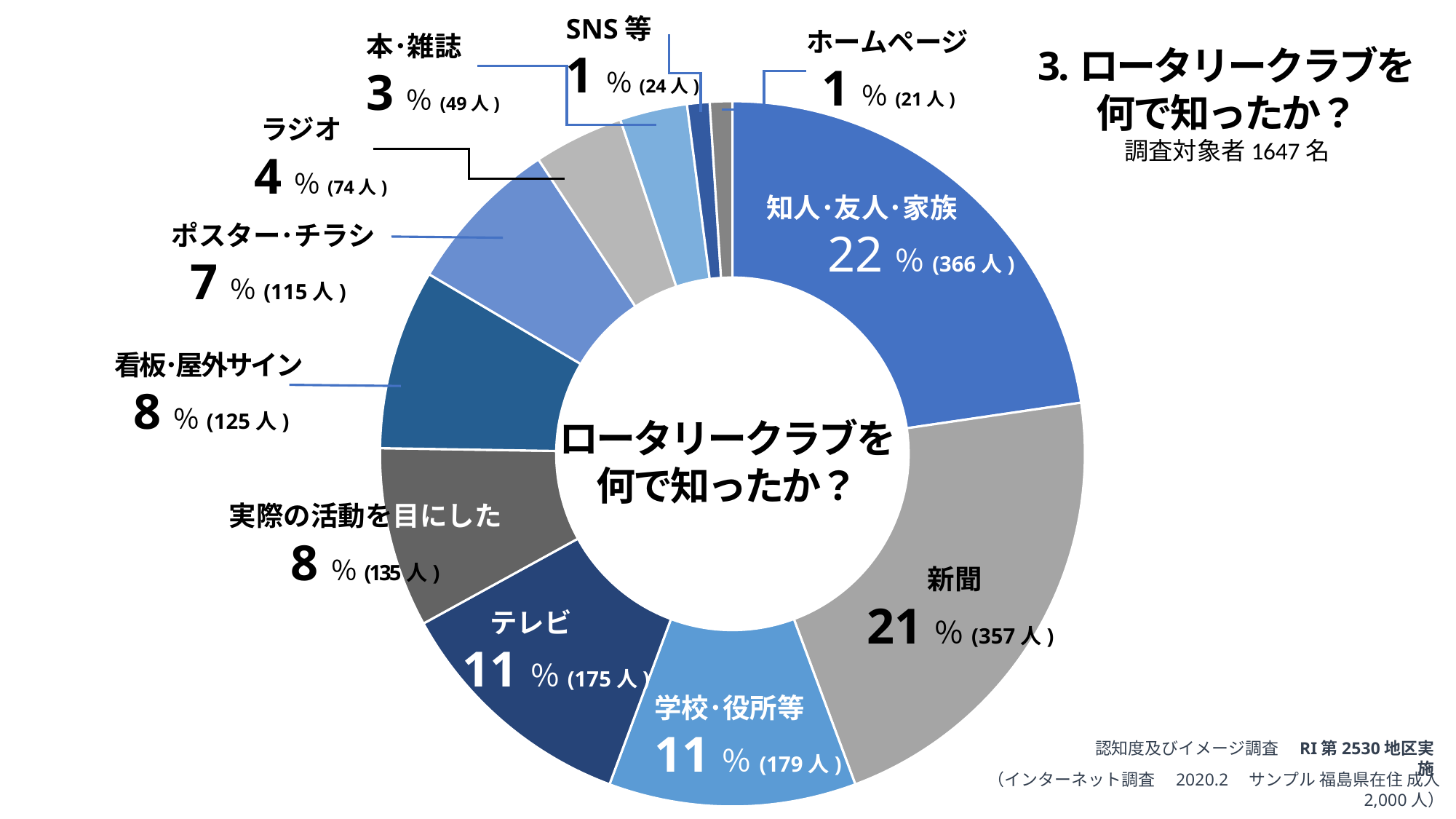
What is the combined percentage of 学校・役所等 and テレビ? 22% What percentage is shown for テレビ? 11% What kind of chart is shown on the slide? Doughnut (pie) chart How many people are shown for ラジオ? 74人 How many people (人) are shown for the 新聞 slice? 357人 How many categories are shown in the chart? 11 What percentage of respondents learned about the Rotary Club from 知人・友人・家族? 22% Which category has the largest share of the doughnut chart? 知人・友人・家族 How many survey respondents (調査対象者) are stated on the slide? 1647名 What is the difference in number of people between 知人・友人・家族 and 新聞? 9人 Which category has the smallest number of people shown? ホームページ (21人) Which has more people, 看板・屋外サイン or 実際の活動を目にした? 実際の活動を目にした